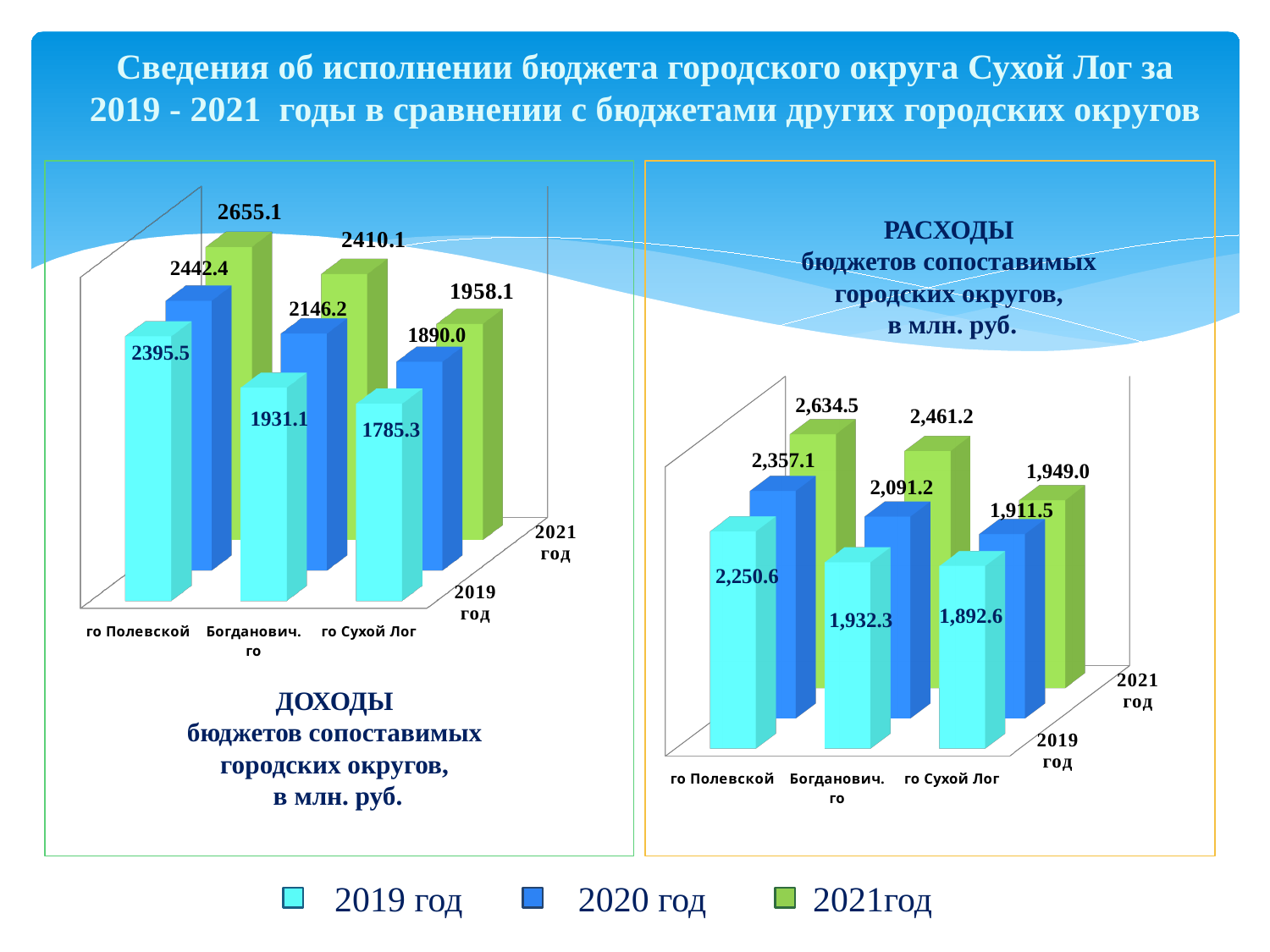
On the ДОХОДЫ chart (left), which city district has the highest value in 2021? го Полевской On the РАСХОДЫ chart (right), which city district has the lowest value in 2019? го Сухой Лог On the ДОХОДЫ chart (left), what is the value for го Полевской in 2021? 2655.1 On the ДОХОДЫ chart (left), what is the difference between the 2021 and 2019 values for го Сухой Лог? 172.8 On the ДОХОДЫ chart (left), what is the value for го Сухой Лог in 2019? 1785.3 On the ДОХОДЫ chart (left), which is larger: Богданович. го in 2020 or го Сухой Лог in 2021? Богданович. го in 2020 What kind of chart is the РАСХОДЫ chart (right)? bar chart On the РАСХОДЫ chart (right), what is the difference between го Полевской and Богданович. го in 2021? 173.3 On the РАСХОДЫ chart (right), what is the value for Богданович. го in 2020? 2,091.2 On the РАСХОДЫ chart (right), what is the value for го Сухой Лог in 2021? 1,949.0 On the ДОХОДЫ chart (left), do the values for го Сухой Лог rise or fall from 2019 to 2021? rise How many series does the legend at the bottom of the slide list? 3